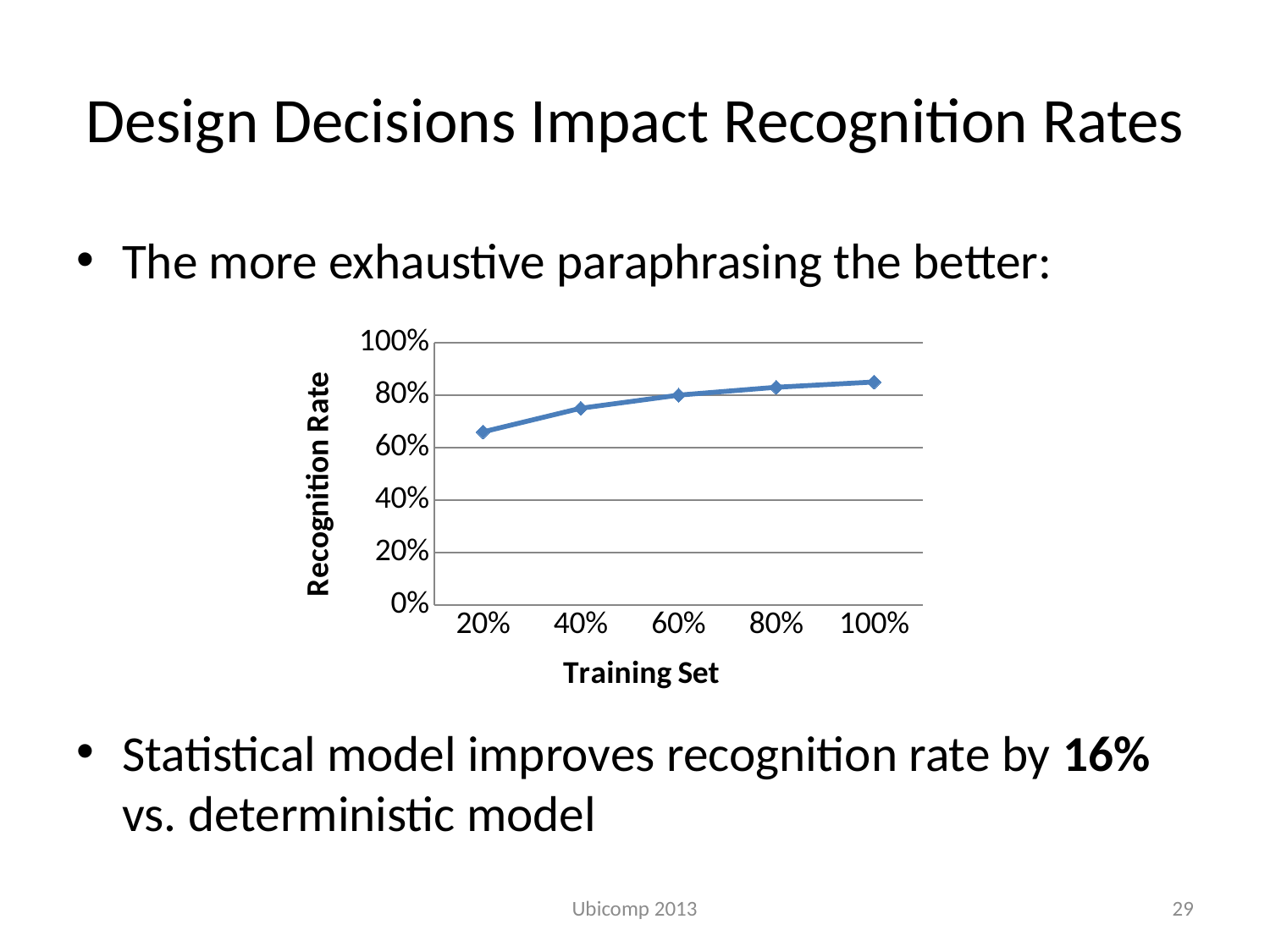
Which training set size has the highest recognition rate? 100% What kind of chart is shown on the slide? line chart Does the recognition rate rise or fall as the training set increases from 20% to 100%? rise How many data points are plotted on the line? 5 Which has a higher recognition rate, the 20% training set or the 100% training set? 100% training set Is the recognition rate at a 40% training set greater or less than 80%? less Is the recognition rate at a 100% training set greater or less than 80%? greater Is the recognition rate at a 20% training set greater or less than 60%? greater Which training set size has the lowest recognition rate? 20% What is the title of the x axis? Training Set What is the title of the y axis? Recognition Rate